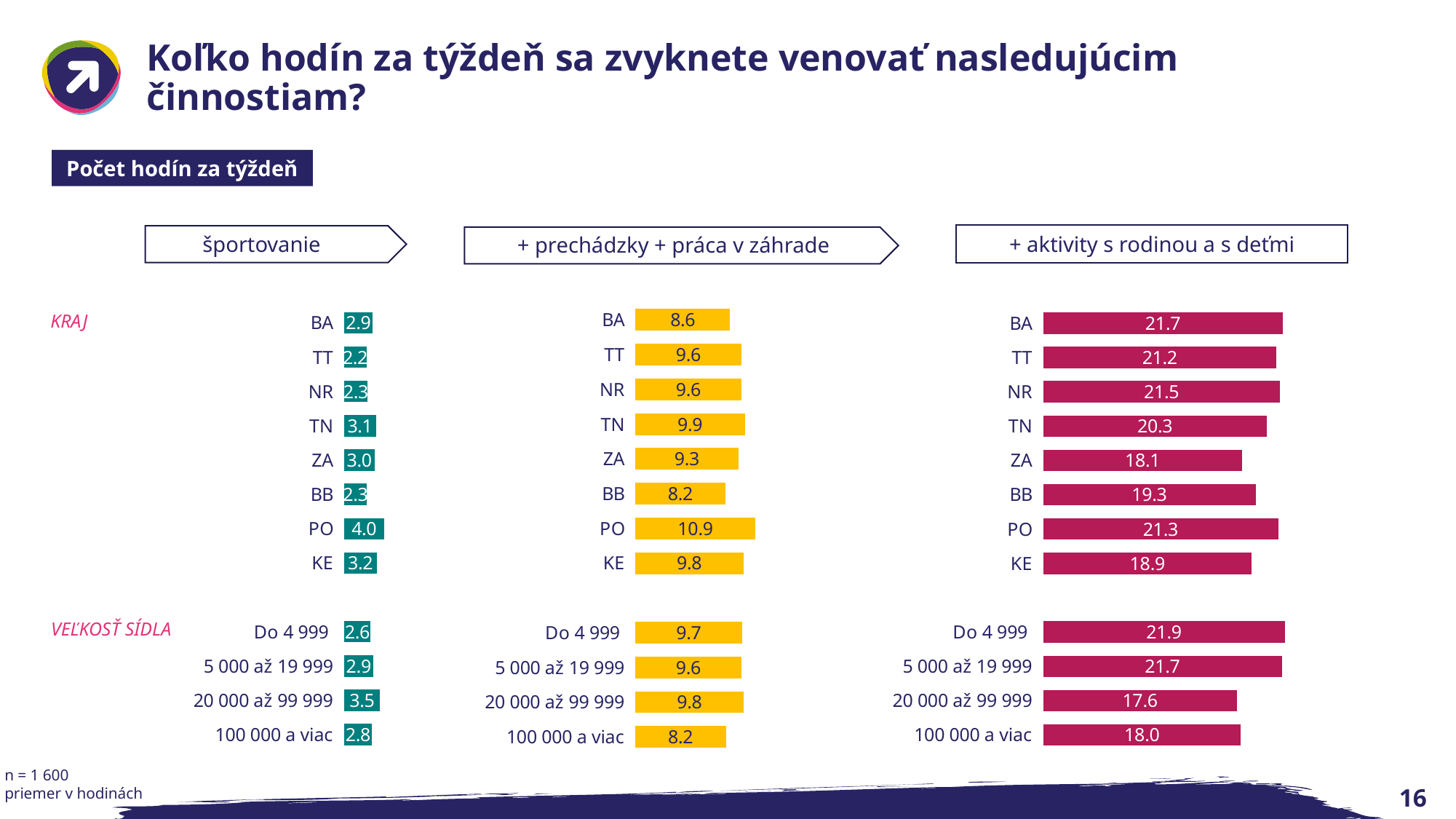
In the "športovanie" chart, which is larger: the value for TN or the value for KE? KE How many regions (KRAJ) are listed in the "+ aktivity s rodinou a s deťmi" chart? 8 In the "+ aktivity s rodinou a s deťmi" chart, what is the difference between Do 4 999 and 100 000 a viac? 3.9 In the "+ prechádzky + práca v záhrade" chart, which region (KRAJ) has the highest value? PO In the "+ aktivity s rodinou a s deťmi" chart, which region (KRAJ) has the lowest value? ZA In the "+ prechádzky + práca v záhrade" chart, what is the difference between PO and BB? 2.7 In the "+ prechádzky + práca v záhrade" chart, what is the value for BB? 8.2 In the "+ aktivity s rodinou a s deťmi" chart, which region (KRAJ) has the highest value? BA What kind of chart is the "+ aktivity s rodinou a s deťmi" chart? bar chart In the "športovanie" chart, what is the value for PO? 4.0 In the "športovanie" chart, which region (KRAJ) has the lowest value? TT In the "+ aktivity s rodinou a s deťmi" chart, what is the value for 20 000 až 99 999? 17.6